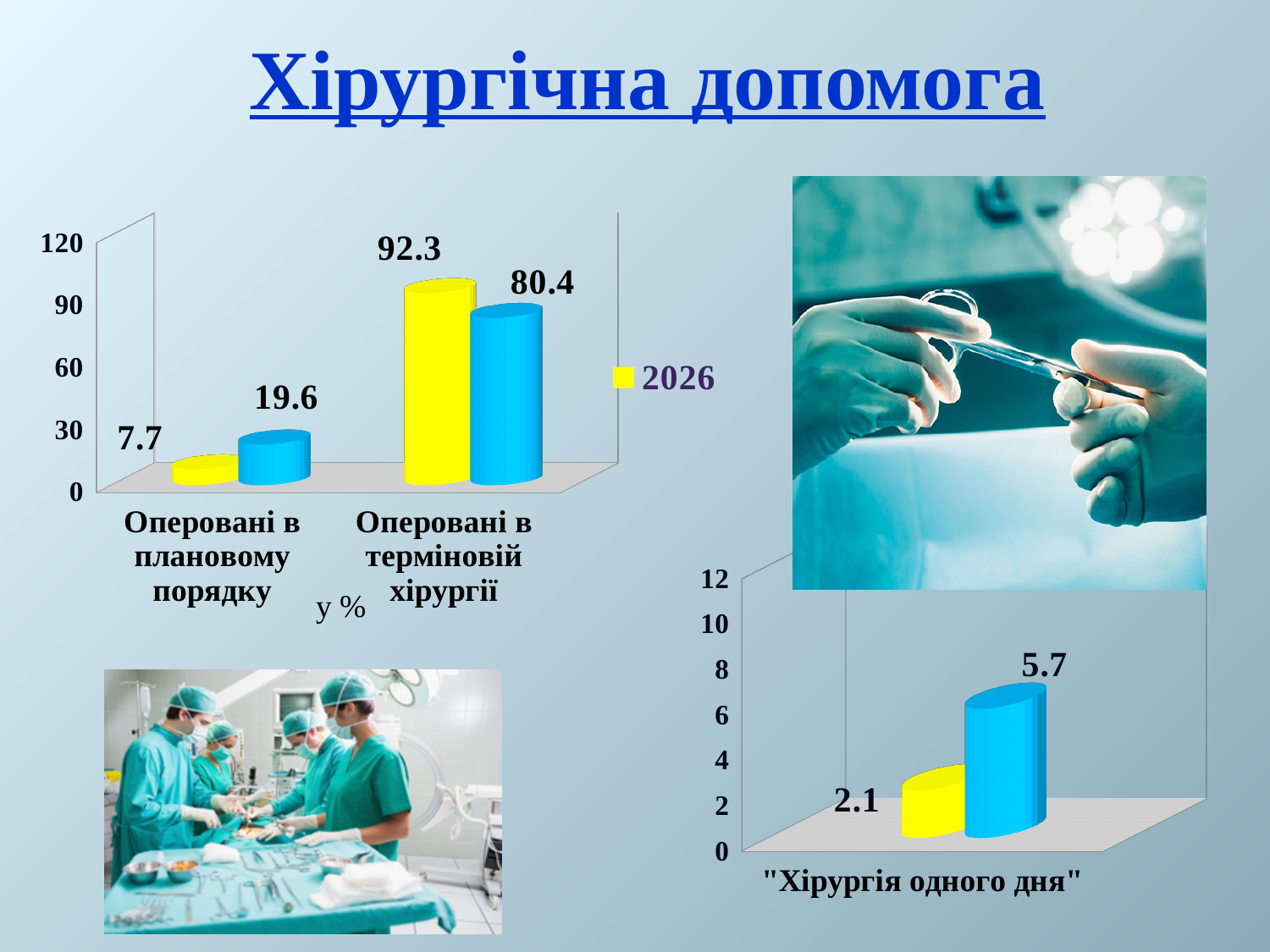
On the bottom-right chart "Хірургія одного дня", what is the difference between the blue and yellow bars? 3.6 On the left chart, which category has the higher 2026 value? Оперовані в терміновій хірургії On the left chart, is the 2026 value for "Оперовані в терміновій хірургії" greater or less than 90? greater On the left chart, what is the 2026 value for "Оперовані в терміновій хірургії"? 92.3 On the left chart, how many categories are shown on the x axis? 2 What type of chart is the left chart? bar chart On the left chart, what value is shown on the blue bar for "Оперовані в плановому порядку"? 19.6 On the left chart, what is the difference between the yellow and blue bars for "Оперовані в терміновій хірургії"? 11.9 On the left chart, what is the 2026 value for "Оперовані в плановому порядку"? 7.7 On the bottom-right chart "Хірургія одного дня", what value is shown on the yellow bar? 2.1 On the left chart, what value is shown on the blue bar for "Оперовані в терміновій хірургії"? 80.4 On the bottom-right chart "Хірургія одного дня", what value is shown on the blue bar? 5.7